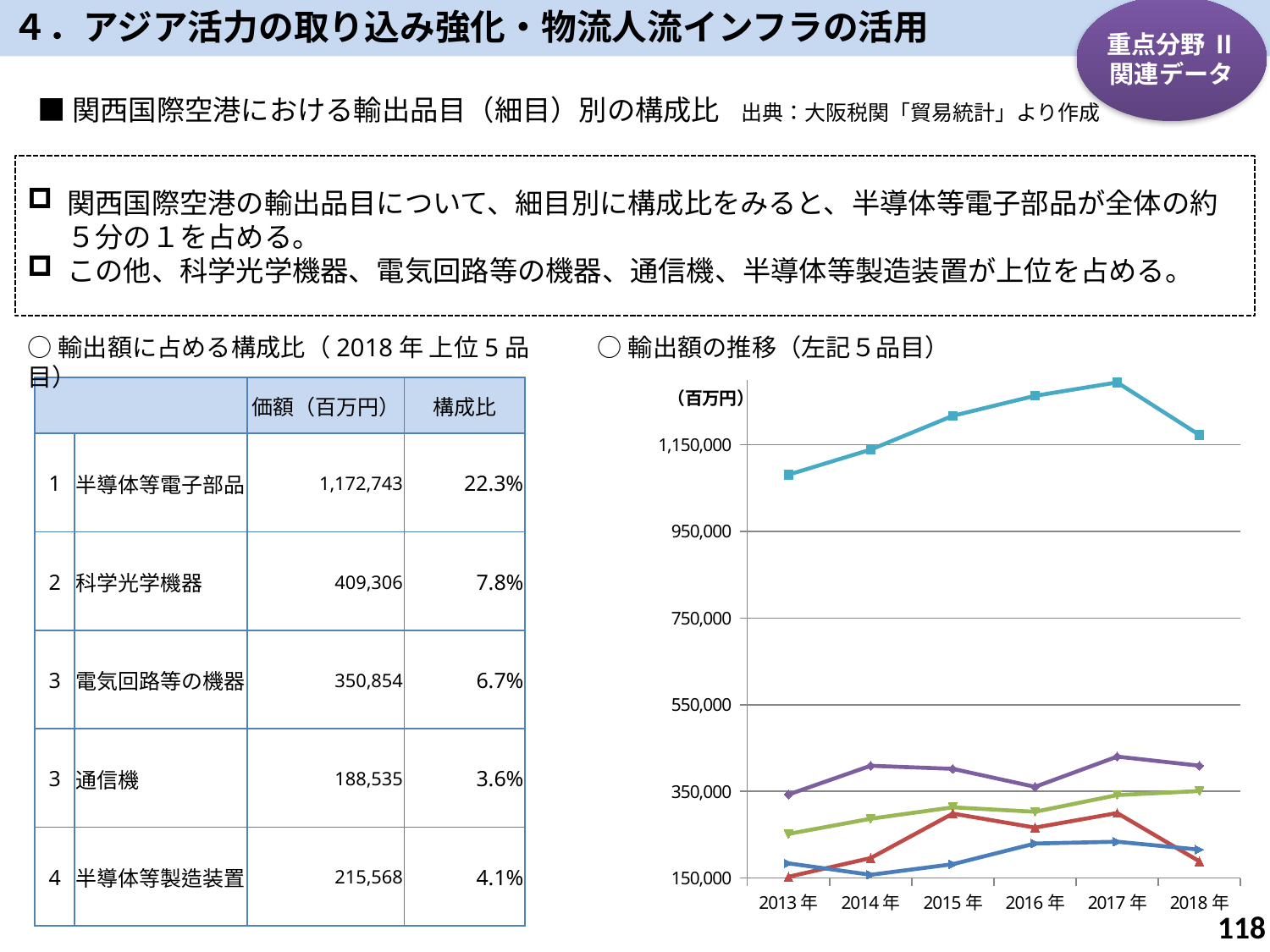
In the chart 「輸出額の推移（左記5品目）」, is the value of the highest line in 2013年 greater or less than 950,000? greater In the chart 「輸出額の推移（左記5品目）」, in which year does the highest line reach its peak? 2017年 In the chart 「輸出額の推移（左記5品目）」, how many lines are plotted? 5 In the chart 「輸出額の推移（左記5品目）」, what is the first year shown on the x axis? 2013年 In the chart 「輸出額の推移（左記5品目）」, what is the lowest value labelled on the y axis? 150,000 In the chart 「輸出額の推移（左記5品目）」, is the value of the highest line in 2017年 greater or less than 1,150,000? greater In the chart 「輸出額の推移（左記5品目）」, is the value of the second-highest line in 2017年 greater or less than 550,000? less In the chart 「輸出額の推移（左記5品目）」, does the highest line rise or fall from 2013年 to 2017年? rises In the chart 「輸出額の推移（左記5品目）」, how many years are shown on the x axis? 6 In the chart 「輸出額の推移（左記5品目）」, what unit is written at the top of the y axis? （百万円） In the chart 「輸出額の推移（左記5品目）」, does the highest line rise or fall from 2017年 to 2018年? falls What kind of chart is shown on the right side of the slide under 「輸出額の推移（左記5品目）」? line chart